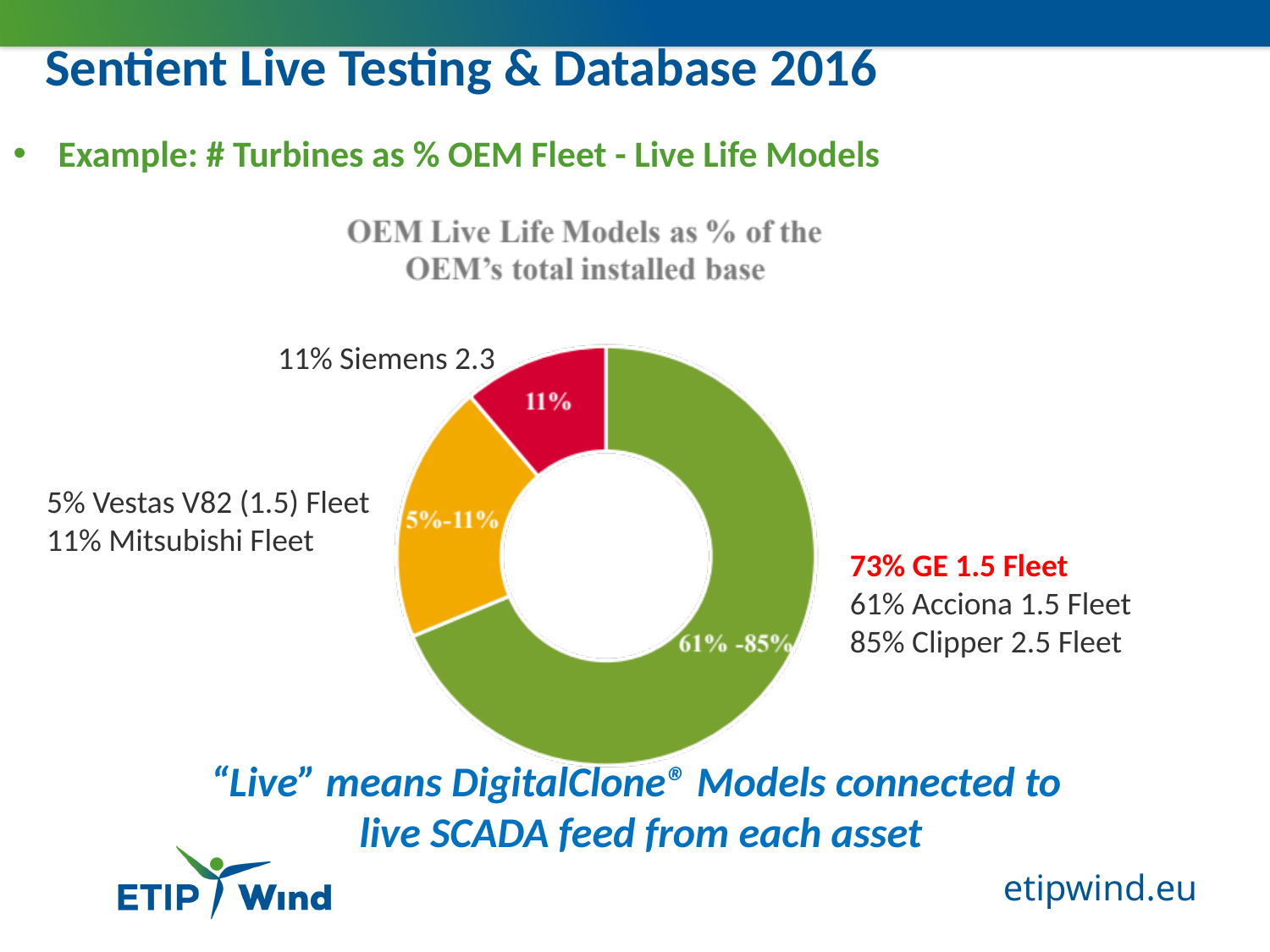
What percentage is shown for the GE 1.5 Fleet? 73% What percentage is shown for the Vestas V82 (1.5) Fleet? 5% What label is printed on the red segment of the donut chart? 11% What label is printed on the orange segment of the donut chart? 5%-11% What label is printed on the green segment of the donut chart? 61% -85% What is the title of the chart? OEM Live Life Models as % of the OEM's total installed base Which colour segment is the smallest in the donut chart? Red What kind of chart is shown on the slide? Donut (pie) chart Which colour segment is the largest in the donut chart? Green Which OEM fleet is annotated next to the red segment of the chart? Siemens 2.3 What percentage is shown for the Clipper 2.5 Fleet? 85% How many segments does the donut chart have? 3